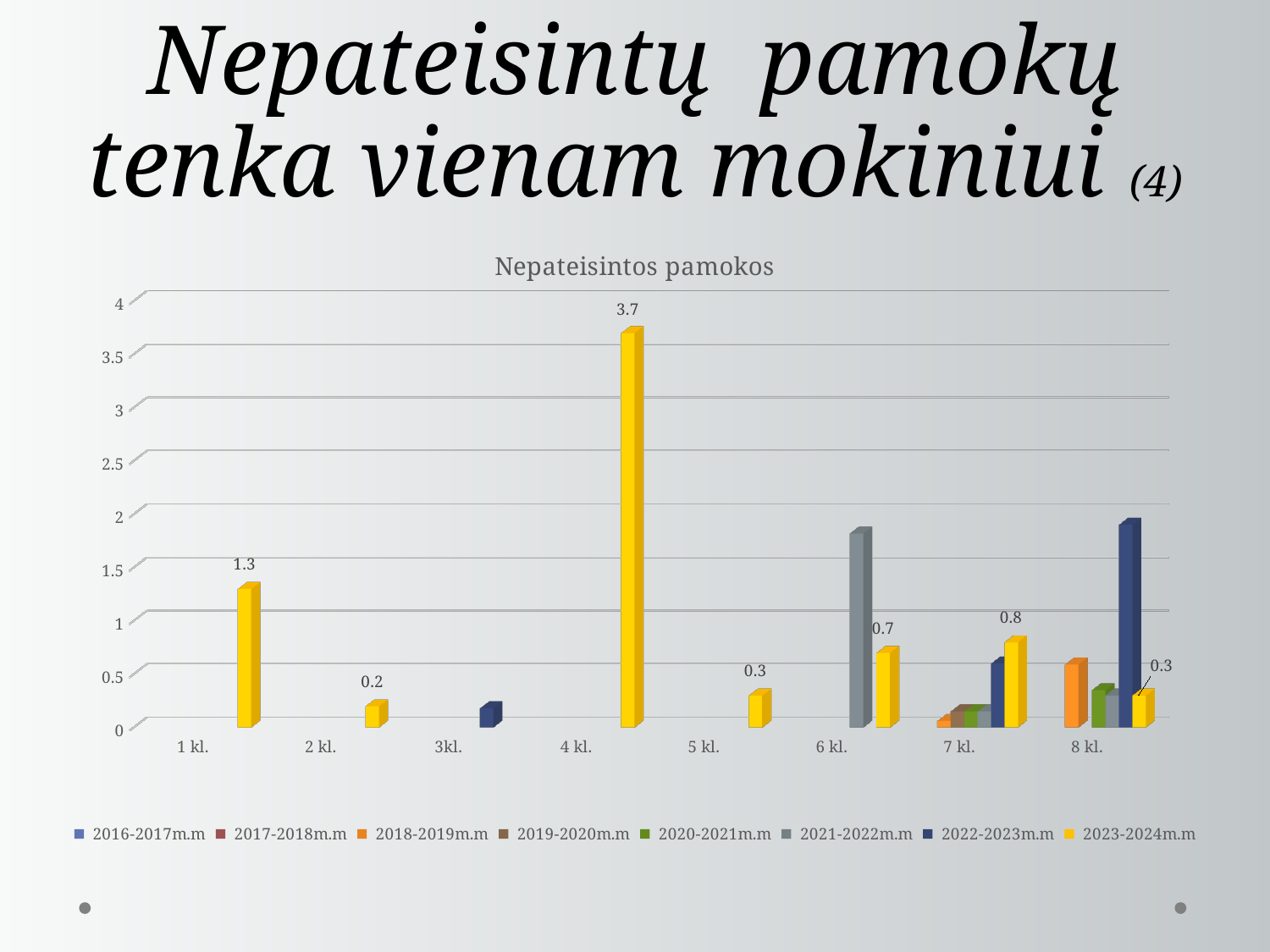
Is the 2022-2023m.m value for 8 kl. greater or less than 1.5? greater How many classes (categories) are shown on the x axis? 8 Which class has the highest 2023-2024m.m value? 4 kl. Which has the larger 2023-2024m.m value, 6 kl. or 7 kl.? 7 kl. What is the difference between the 2023-2024m.m values for 4 kl. and 1 kl.? 2.4 How many series does the legend list? 8 What is the 2023-2024m.m value for 6 kl.? 0.7 What is the 2023-2024m.m value for 1 kl.? 1.3 Among the labelled 2023-2024m.m values, which class has the lowest? 2 kl. What kind of chart is shown on the slide? Bar chart Is the 2021-2022m.m value for 6 kl. greater or less than 1.5? greater What is the 2023-2024m.m value for 4 kl.? 3.7